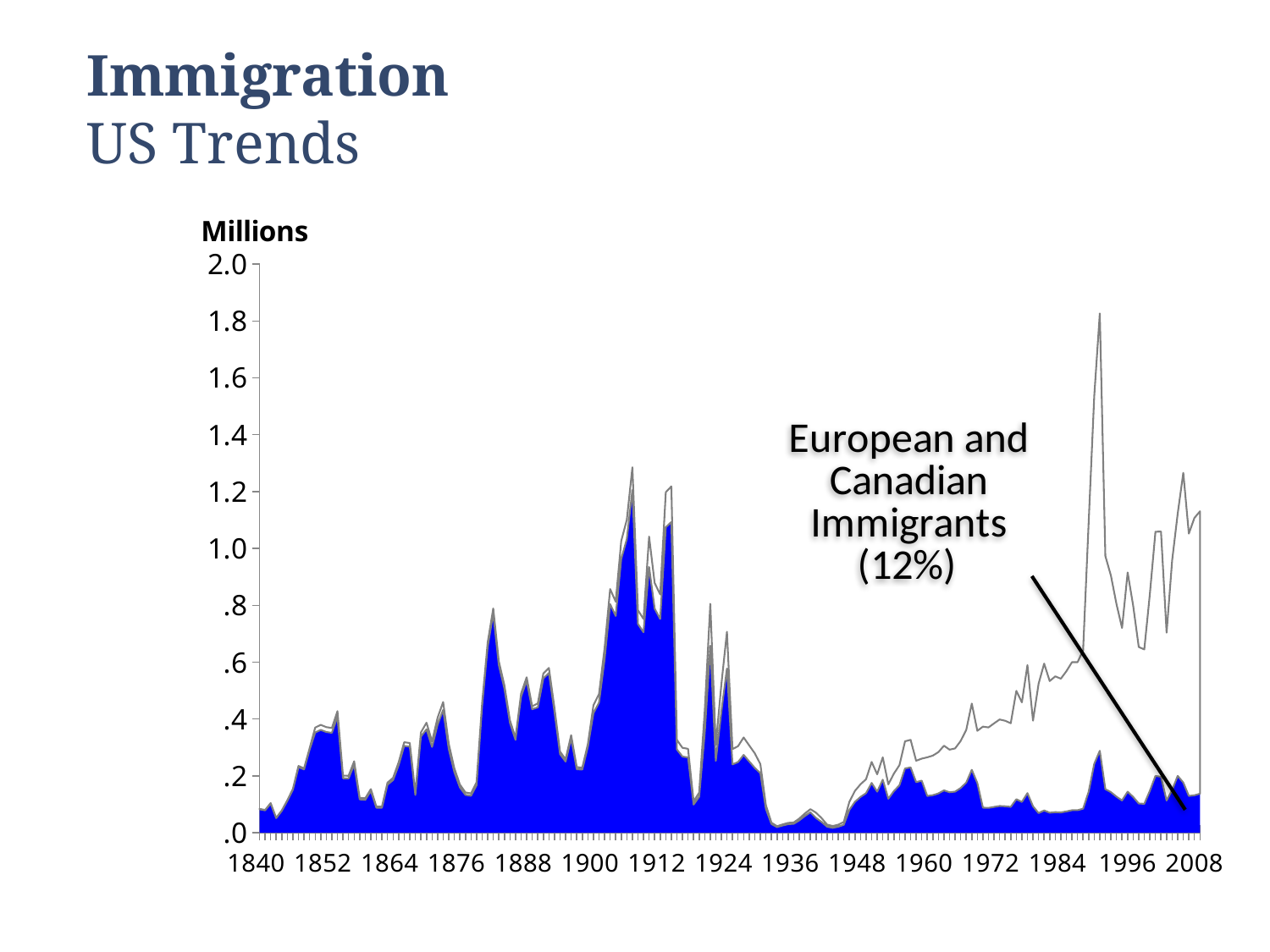
What does the annotation on the chart say the blue shaded area represents? European and Canadian Immigrants (12%) Is the value of the blue shaded area in 2008 greater or less than 0.2 million? less Does the gray total line generally rise or fall between 1948 and 1984? rise Does the highest peak of the gray total line occur before or after 1984? after What is the first year labelled on the x axis of the chart? 1840 Is the value of the gray total line around 1940 greater or less than 0.2 million? less What is the last year labelled on the x axis of the chart? 2008 Is the value of the blue shaded area at its peak around 1907 greater or less than 0.8 million? greater How many year labels are shown along the x axis? 15 What unit is given for the vertical axis of the chart? Millions What kind of chart is shown on the slide? Area chart